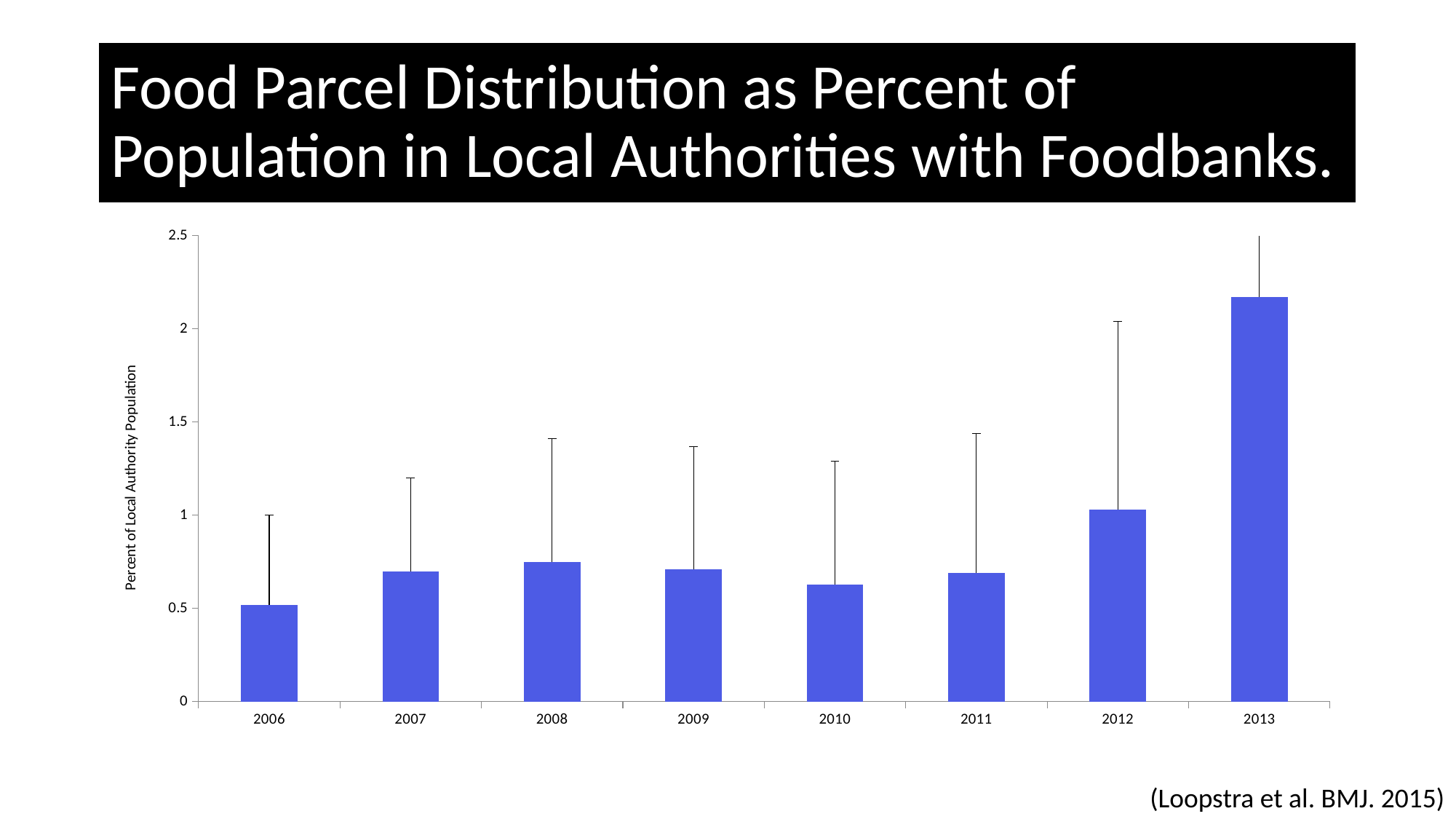
Which year has the highest percent of local authority population receiving food parcels? 2013 Is the value for 2012 greater or less than 1.5? less What kind of chart is shown on the slide? Bar chart Which year has the lowest percent of local authority population receiving food parcels? 2006 Which year has the larger value, 2006 or 2007? 2007 Is the value for 2010 greater or less than 0.5? greater Is the value for 2013 greater or less than 2? greater How many years are plotted on the chart? 8 Which year has the larger value, 2012 or 2013? 2013 Overall, do the values rise or fall from 2006 to 2013? Rise What is the label on the vertical axis of the chart? Percent of Local Authority Population